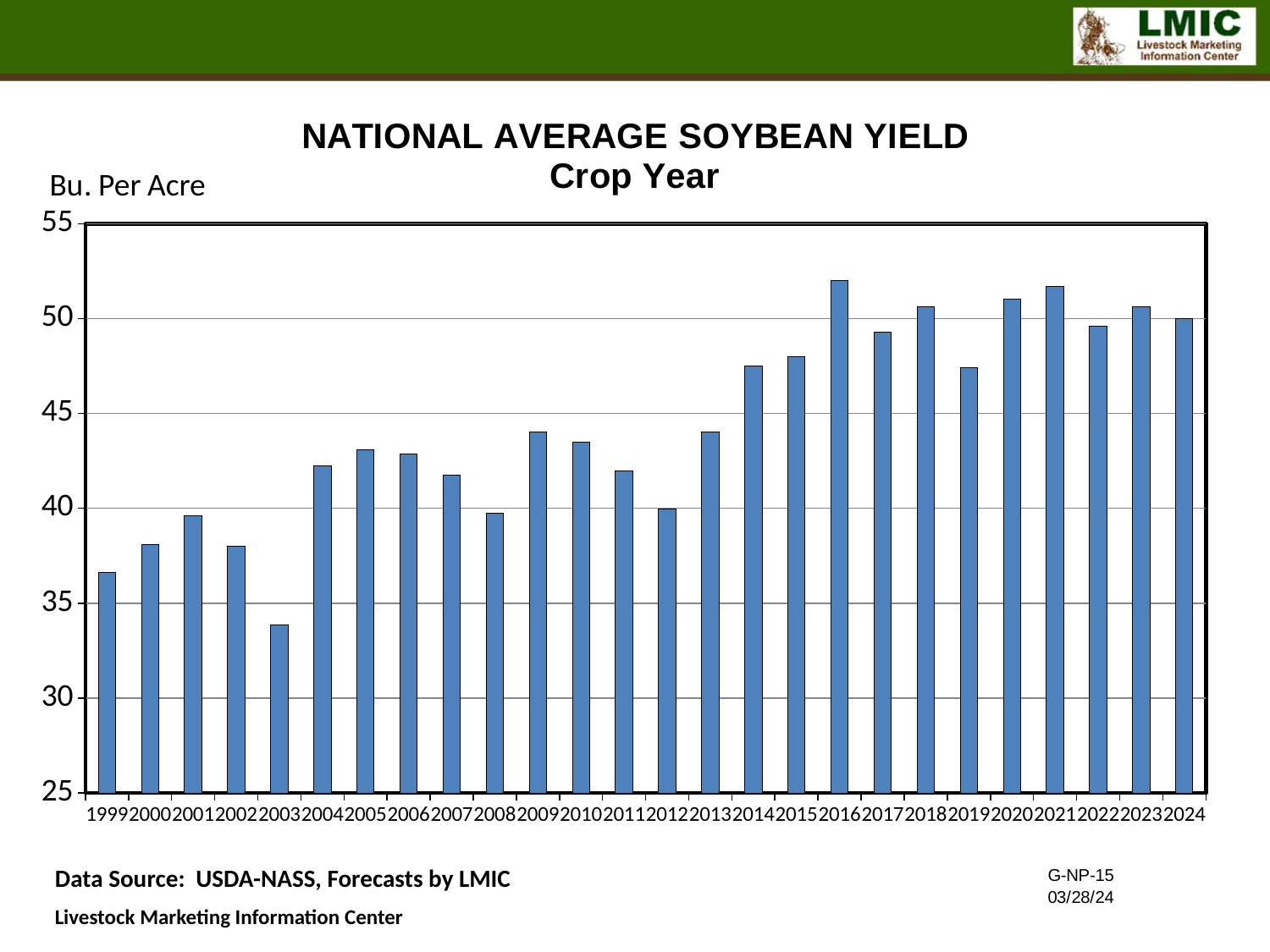
How many crop years are plotted in the chart? 26 Which crop year has the larger soybean yield, 2016 or 2017? 2016 What is the title of the chart? NATIONAL AVERAGE SOYBEAN YIELD Is the value for 2016 greater or less than 50? greater What unit is shown on the y axis of the chart? Bu. Per Acre Overall, do soybean yields rise or fall from 1999 to 2024? rise Is the value for 2019 greater or less than 50? less Is the value for 2014 greater or less than 45? greater Which crop year has the lowest national average soybean yield? 2003 What kind of chart is shown on the slide? bar chart Which crop year has the highest national average soybean yield? 2016